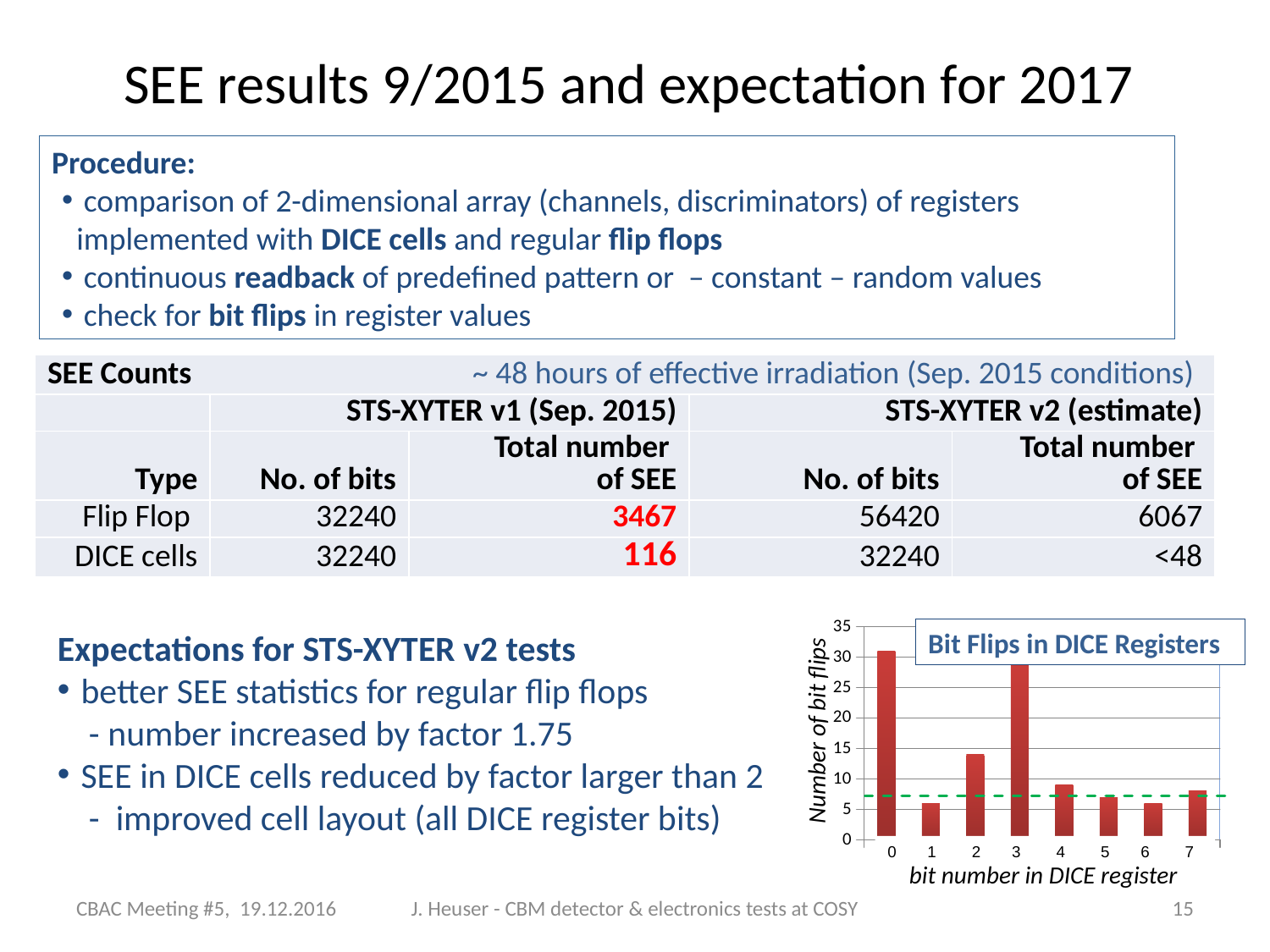
Is the number of bit flips for bit number 3 greater or less than 25? greater Is the number of bit flips for bit number 1 greater or less than 10? less Which has more bit flips, bit number 2 or bit number 4? bit number 2 Is the number of bit flips for bit number 0 greater or less than 25? greater Which bit number has the highest number of bit flips in the chart? 0 Which has more bit flips, bit number 3 or bit number 5? bit number 3 What kind of chart is shown on the slide? bar chart What is the title of the chart on the slide? Bit Flips in DICE Registers What is the label of the y axis of the chart? Number of bit flips How many bit numbers are plotted on the x axis of the chart? 8